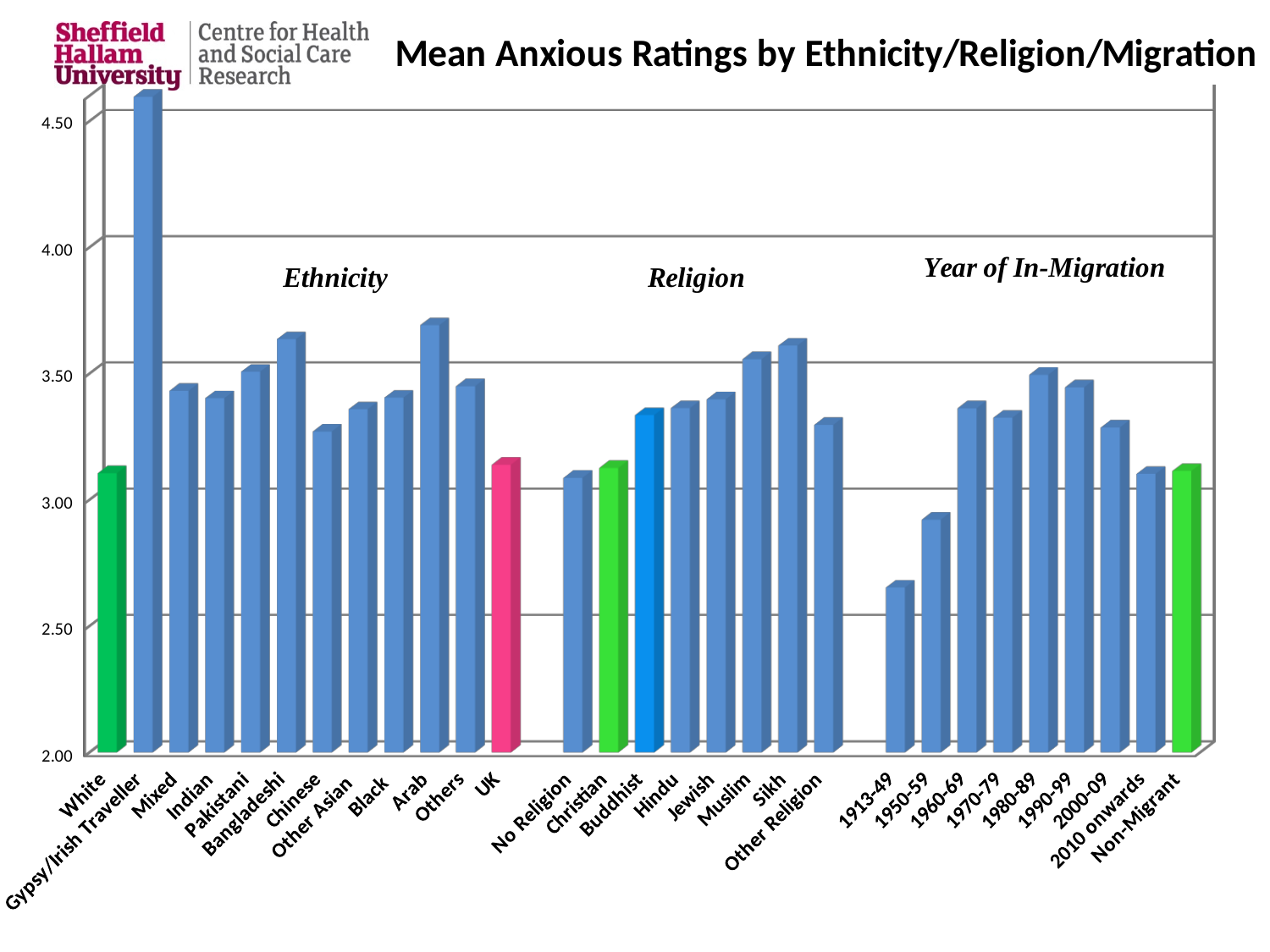
Which has the higher mean anxious rating, Arab or Chinese? Arab What is the title of the chart? Mean Anxious Ratings by Ethnicity/Religion/Migration How many categories are plotted on the x axis? 29 Is the value for 1913-49 greater or less than 3.00? less Is the value for Chinese greater or less than 3.50? less Which category has the highest mean anxious rating? Gypsy/Irish Traveller Is the value for 1950-59 greater or less than 3.00? less What kind of chart is shown on the slide? bar chart Which category has the lowest mean anxious rating? 1913-49 Which has the higher mean anxious rating, Sikh or Other Religion? Sikh